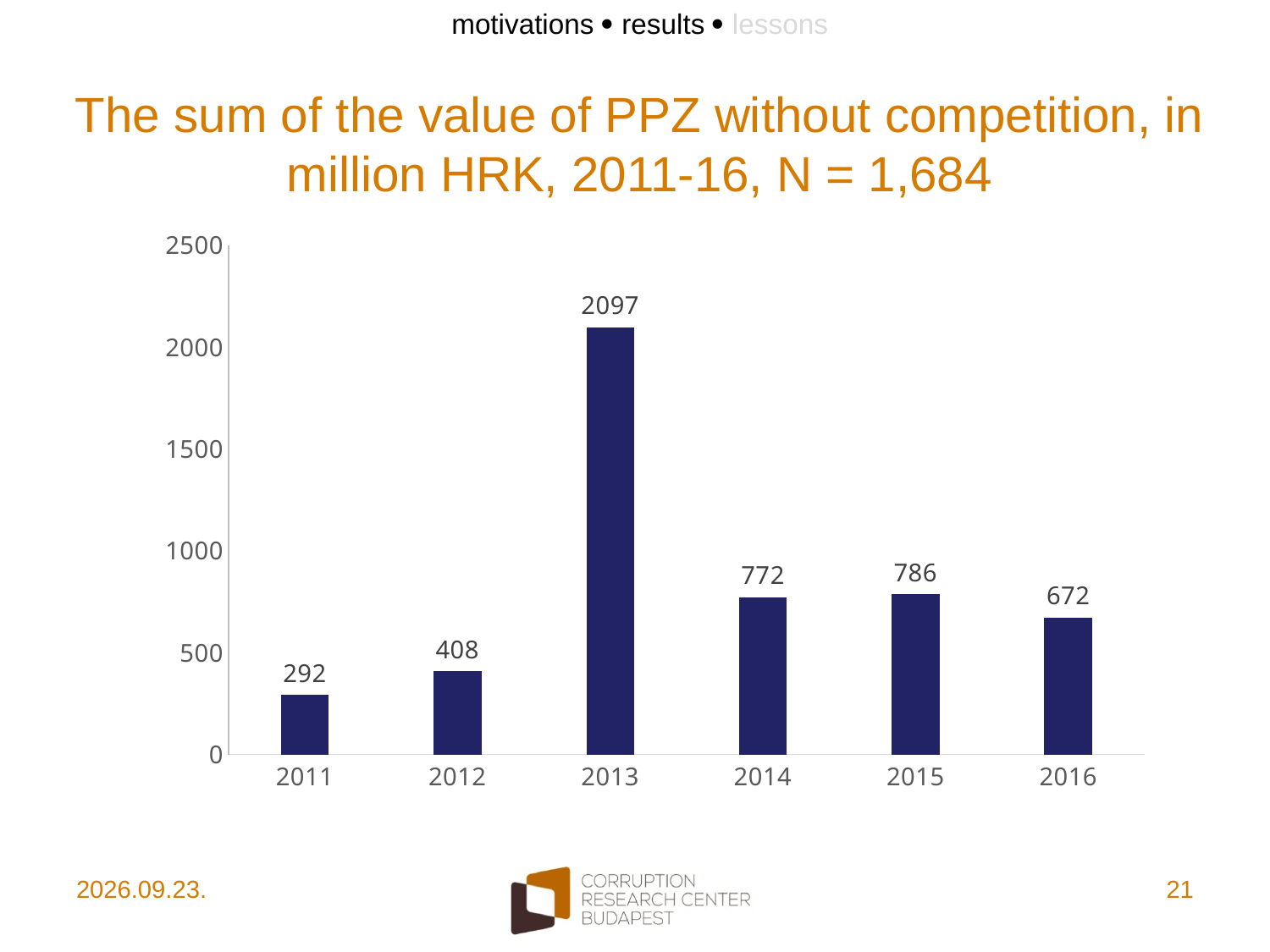
Is the value for 2015 greater or less than 1000? less How many years are shown on the x axis? 6 Which year has the lowest value? 2011 Which year has the highest value? 2013 What kind of chart is shown on the slide? bar chart What is the value for 2013? 2097 What is the difference between the values for 2012 and 2011? 116 Do the values rise or fall from 2011 to 2013? rise What is the value for 2011? 292 What is the difference between the values for 2013 and 2014? 1325 Which is larger, the value for 2014 or the value for 2016? 2014 What is the value for 2016? 672